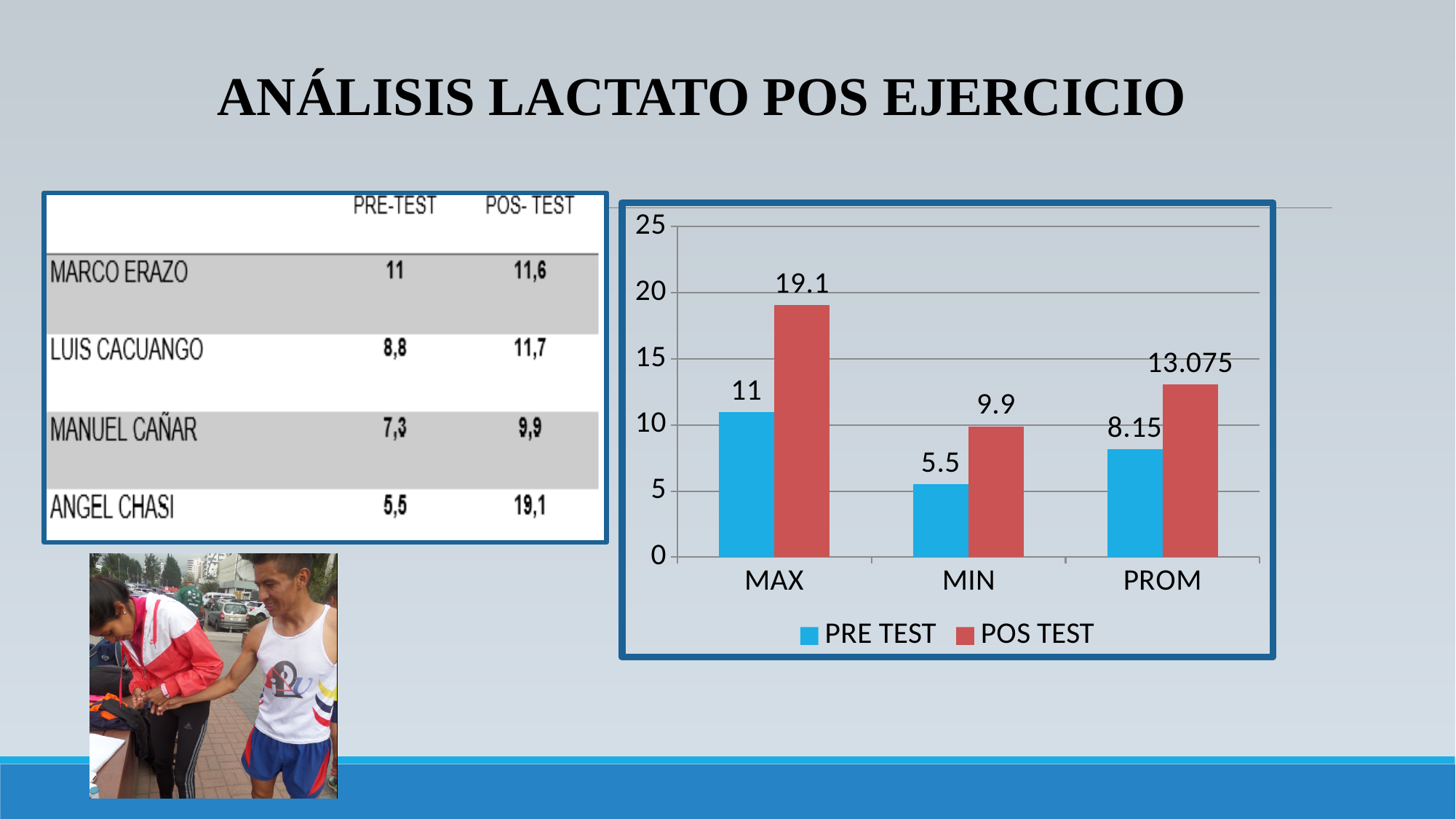
What is the difference between the POS TEST and PRE TEST values for MAX? 8.1 How many series does the chart legend list? 2 Which category has the highest POS TEST value? MAX Which category has the lowest PRE TEST value? MIN What is the PRE TEST value for MAX? 11 How many categories are shown on the x axis of the chart? 3 What is the POS TEST value for MAX? 19.1 What is the PRE TEST value for MIN? 5.5 Is the POS TEST value for PROM greater or less than 10? greater What is the POS TEST value for PROM? 13.075 Which is larger for MIN, the PRE TEST value or the POS TEST value? POS TEST What kind of chart is shown on the slide? Bar chart